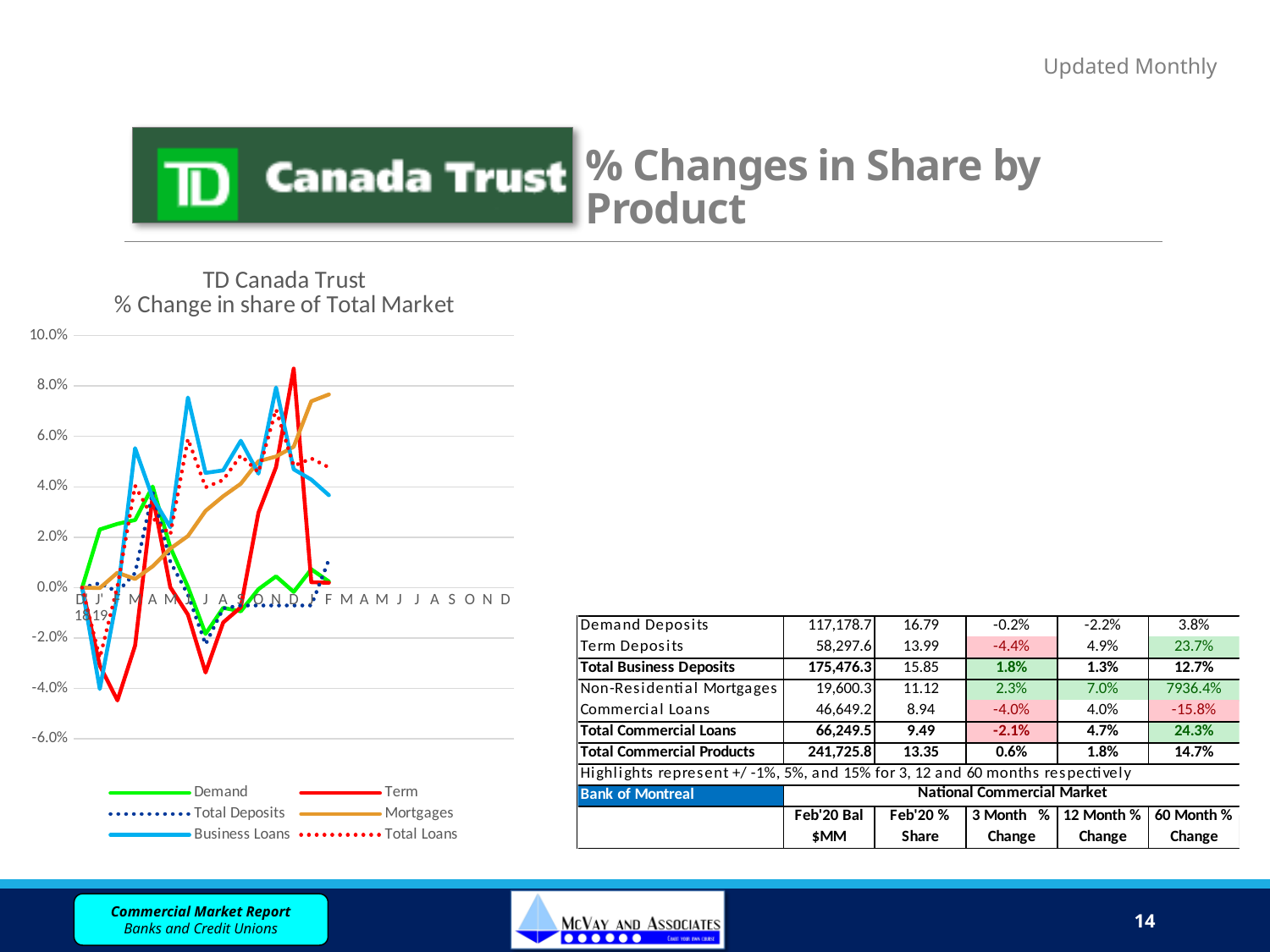
Is the final plotted value of the Demand series greater or less than 2.0%? less At the last plotted point, which series is higher: Mortgages or Business Loans? Mortgages Which series reaches the highest value anywhere on the chart? Term Is the final plotted value of the Mortgages series greater or less than 6.0%? greater What is the title of the chart? TD Canada Trust % Change in share of Total Market Which series is drawn in orange in the chart? Mortgages How many series does the chart legend list? 6 Is the lowest point of the Business Loans series greater or less than -2.0%? less What kind of chart is shown on the slide? line chart Does the Mortgages series generally rise or fall along the x axis? rise